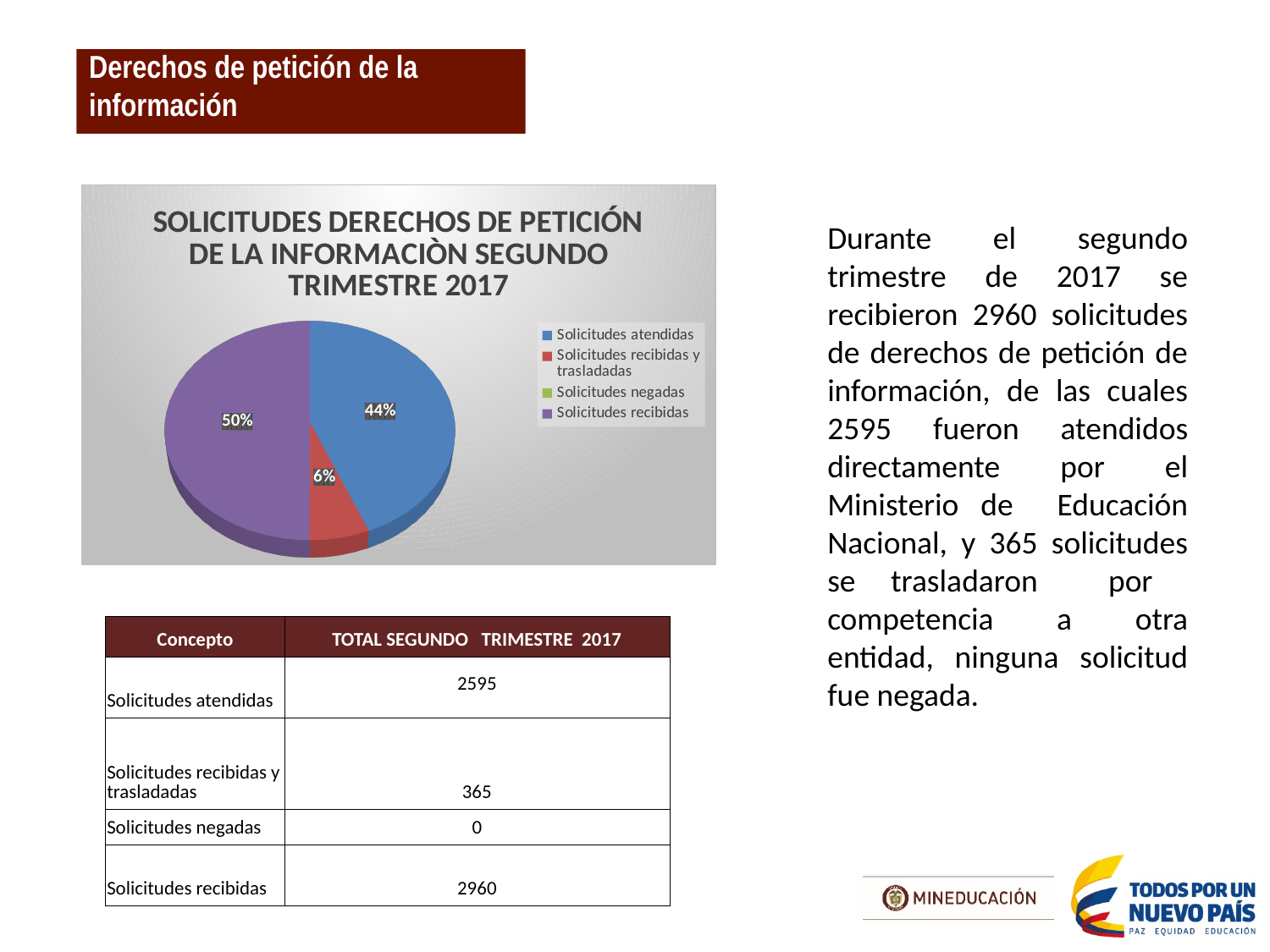
What is the title of the pie chart? SOLICITUDES DERECHOS DE PETICIÓN DE LA INFORMACIÒN SEGUNDO TRIMESTRE 2017 What share of the pie is taken by 'Solicitudes recibidas'? 50% What is the difference in percentage points between the 'Solicitudes recibidas' slice and the 'Solicitudes atendidas' slice? 6% What percentage of the pie does 'Solicitudes recibidas y trasladadas' represent? 6% Which is larger, the slice for 'Solicitudes atendidas' or the slice for 'Solicitudes recibidas y trasladadas'? Solicitudes atendidas What kind of chart is shown on the slide? pie chart What colour is the slice for 'Solicitudes recibidas'? purple How many percentage labels are shown on the pie? 3 Which category has the largest slice of the pie? Solicitudes recibidas What percentage of the pie does 'Solicitudes recibidas' represent? 50% What percentage of the pie does 'Solicitudes atendidas' represent? 44% How many entries does the chart legend list? 4